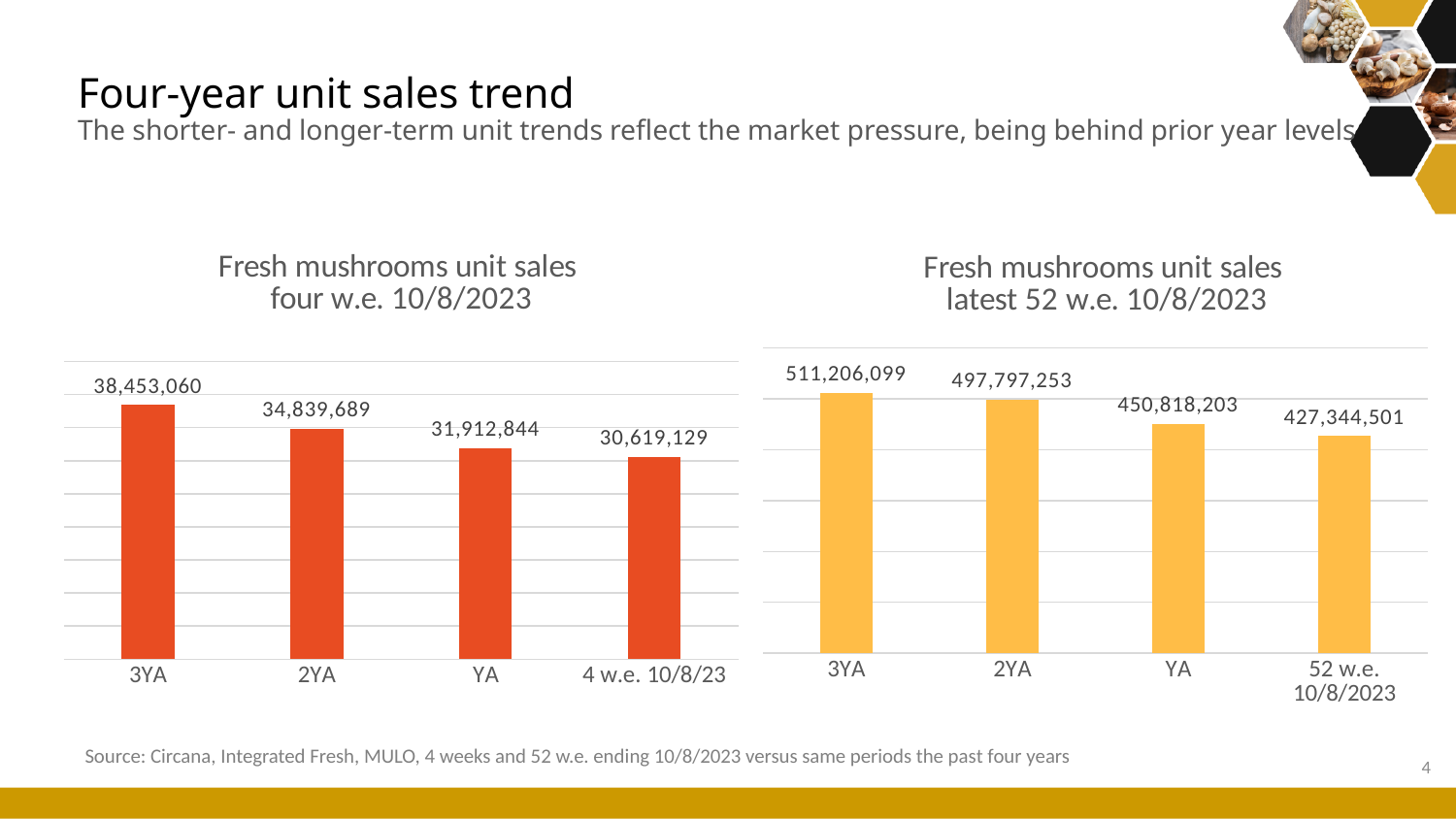
In the 'Fresh mushrooms unit sales four w.e. 10/8/2023' chart, what is the difference between the 3YA value and the 4 w.e. 10/8/23 value? 7,833,931 In the 'Fresh mushrooms unit sales latest 52 w.e. 10/8/2023' chart, what is the value for 52 w.e. 10/8/2023? 427,344,501 In the 'Fresh mushrooms unit sales four w.e. 10/8/2023' chart, which category has the highest value? 3YA In the 'Fresh mushrooms unit sales latest 52 w.e. 10/8/2023' chart, what is the difference between the 2YA value and the YA value? 46,979,050 What kind of chart is the 'Fresh mushrooms unit sales latest 52 w.e. 10/8/2023' chart? Bar chart How many bars are in the 'Fresh mushrooms unit sales four w.e. 10/8/2023' chart? 4 In the 'Fresh mushrooms unit sales latest 52 w.e. 10/8/2023' chart, which is larger, the value for 3YA or the value for 2YA? 3YA In the 'Fresh mushrooms unit sales four w.e. 10/8/2023' chart, do the values rise or fall from 3YA to 4 w.e. 10/8/23? Fall In the 'Fresh mushrooms unit sales four w.e. 10/8/2023' chart, what is the value for 3YA? 38,453,060 In the 'Fresh mushrooms unit sales four w.e. 10/8/2023' chart, what is the value for 4 w.e. 10/8/23? 30,619,129 In the 'Fresh mushrooms unit sales latest 52 w.e. 10/8/2023' chart, what is the value for YA? 450,818,203 In the 'Fresh mushrooms unit sales latest 52 w.e. 10/8/2023' chart, which category has the lowest value? 52 w.e. 10/8/2023